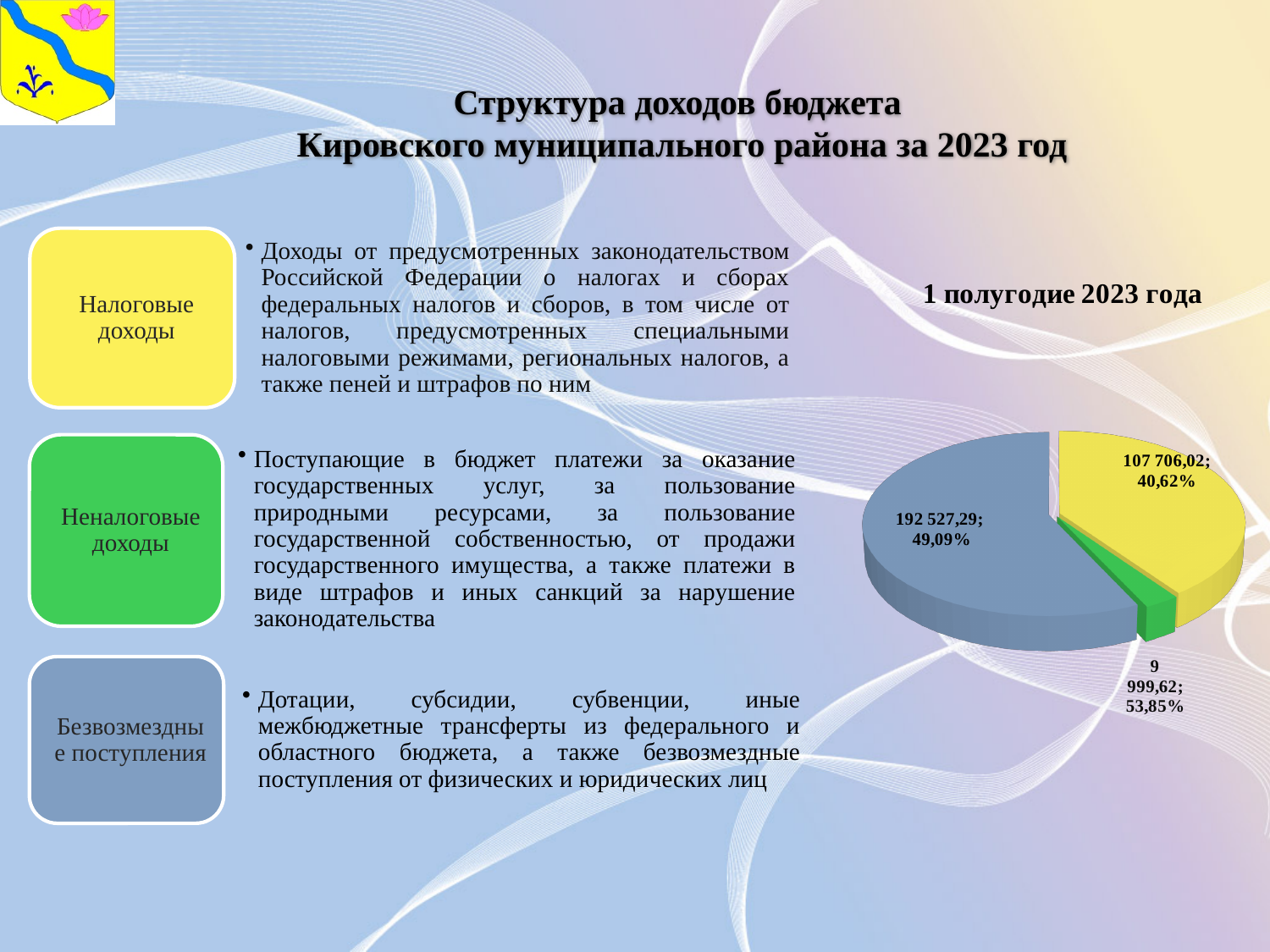
How many slices does the pie chart have? 3 What is the title shown above the pie chart? 1 полугодие 2023 года Which slice of the pie chart has the smallest value? the green slice (9 999,62) What value is labelled on the yellow slice of the pie chart? 107 706,02 What percentage share is printed on the blue slice of the pie chart? 49,09% What value is labelled on the green slice of the pie chart? 9 999,62 Which is larger in the pie chart, the yellow slice or the blue slice? the blue slice What value is labelled on the blue slice of the pie chart? 192 527,29 What kind of chart is shown on the slide? pie chart What percentage share is printed on the yellow slice of the pie chart? 40,62% What is the difference between the blue slice value and the yellow slice value in the pie chart? 84 821,27 Which slice of the pie chart has the largest value? the blue slice (192 527,29)